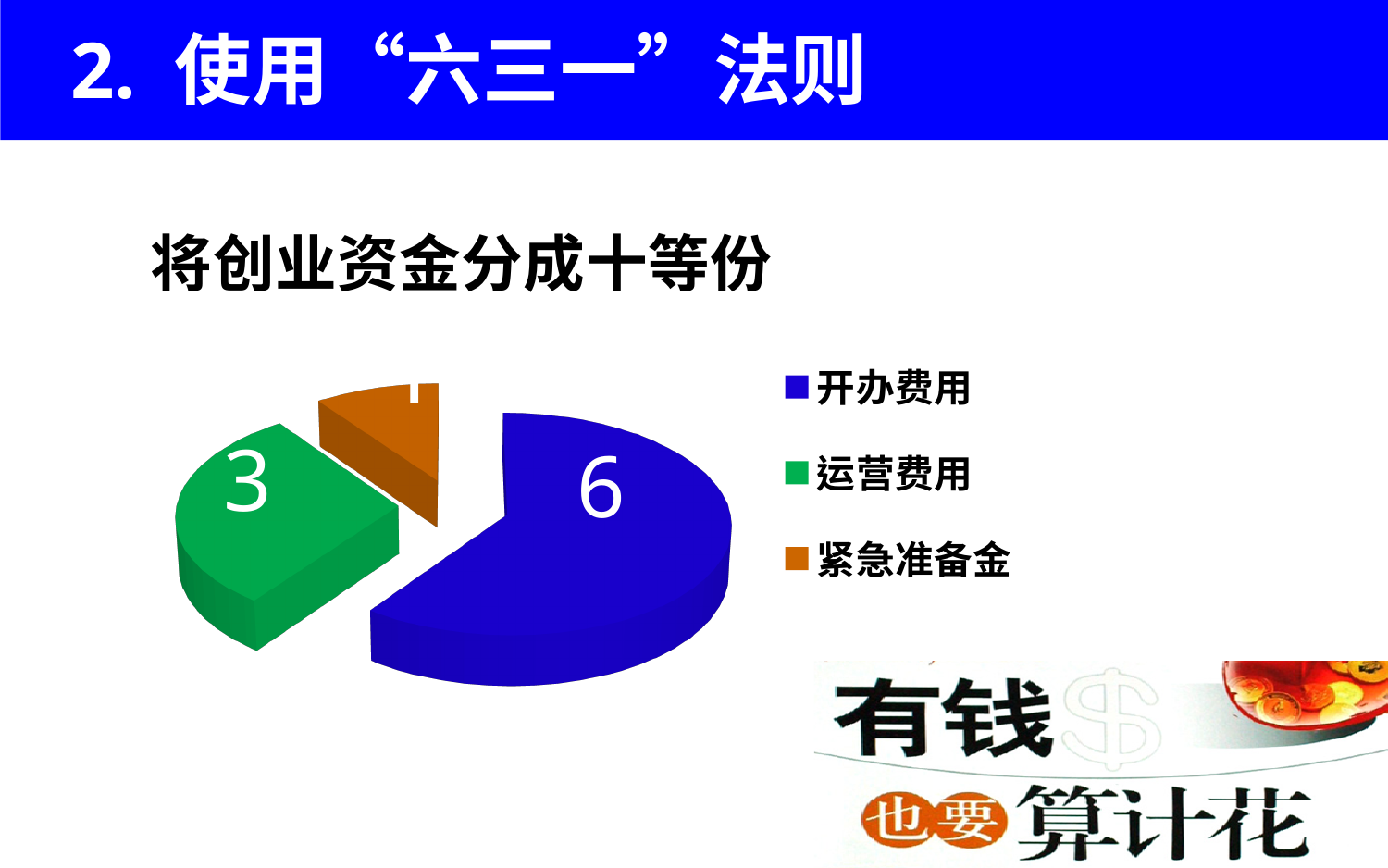
What colour is the 开办费用 slice? blue Which is larger, 运营费用 or 紧急准备金? 运营费用 What is the value shown for 运营费用 in the pie chart? 3 Which is larger, 开办费用 or 运营费用? 开办费用 What kind of chart is shown on the slide? pie chart What is the value shown for 开办费用 in the pie chart? 6 How many slices does the pie chart have? 3 What is the difference between the values for 开办费用 and 运营费用? 3 How many entries does the legend list? 3 What colour is the 紧急准备金 slice? orange Which category has the largest slice in the pie chart? 开办费用 Which category has the smallest slice in the pie chart? 紧急准备金